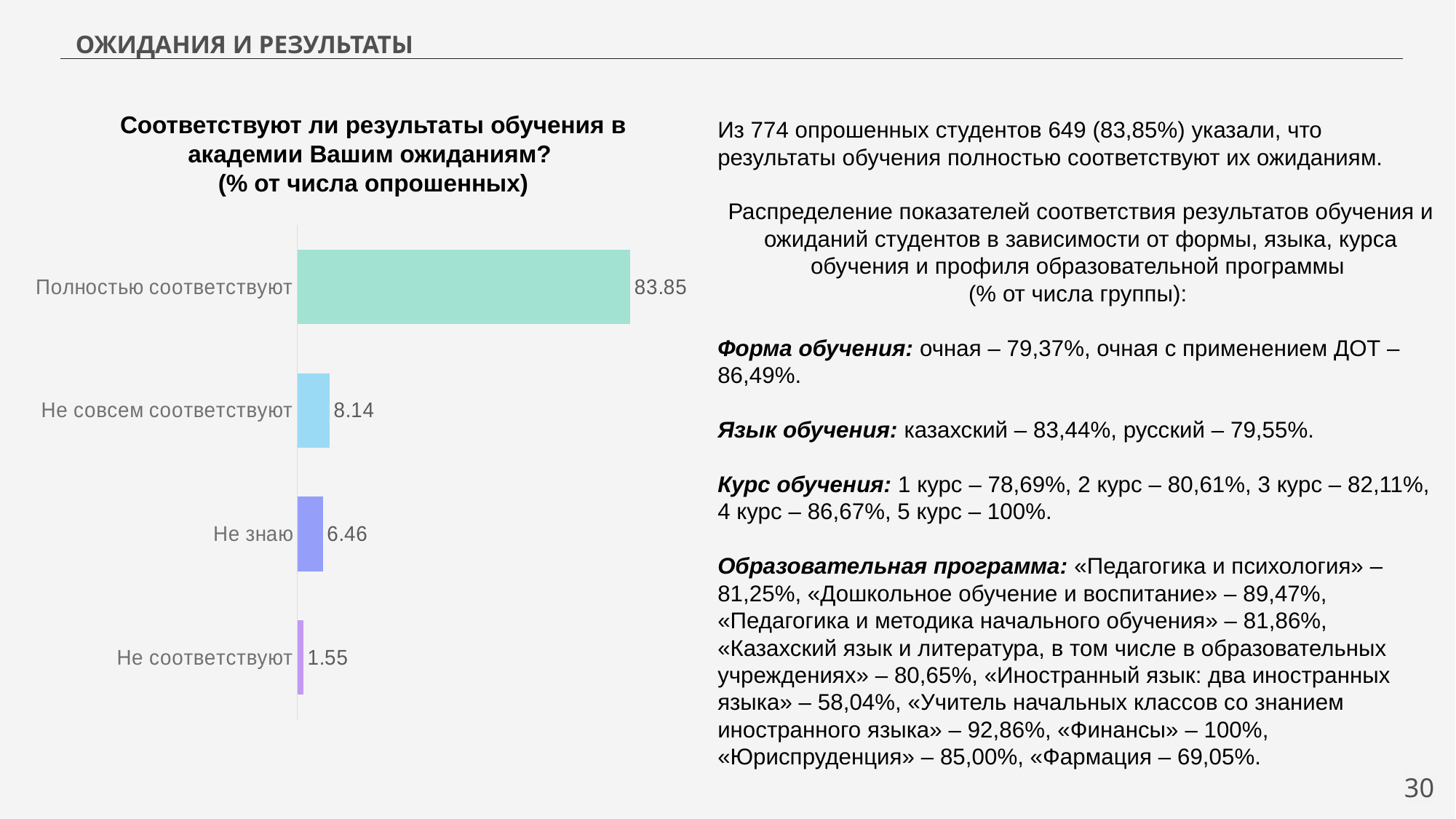
What colour is the bar for «Полностью соответствуют»? Light green (mint) Which category has the highest value? Полностью соответствуют Which is larger, the value for «Не знаю» or the value for «Не соответствуют»? Не знаю How many categories are shown in the chart? 4 What is the difference between the values for «Полностью соответствуют» and «Не совсем соответствуют»? 75.71 What is the value for «Полностью соответствуют»? 83.85 What kind of chart is shown on the slide? Bar chart What is the value for «Не соответствуют»? 1.55 What is the value for «Не совсем соответствуют»? 8.14 What is the difference between the values for «Не совсем соответствуют» and «Не знаю»? 1.68 Which category has the lowest value? Не соответствуют What is the value for «Не знаю»? 6.46